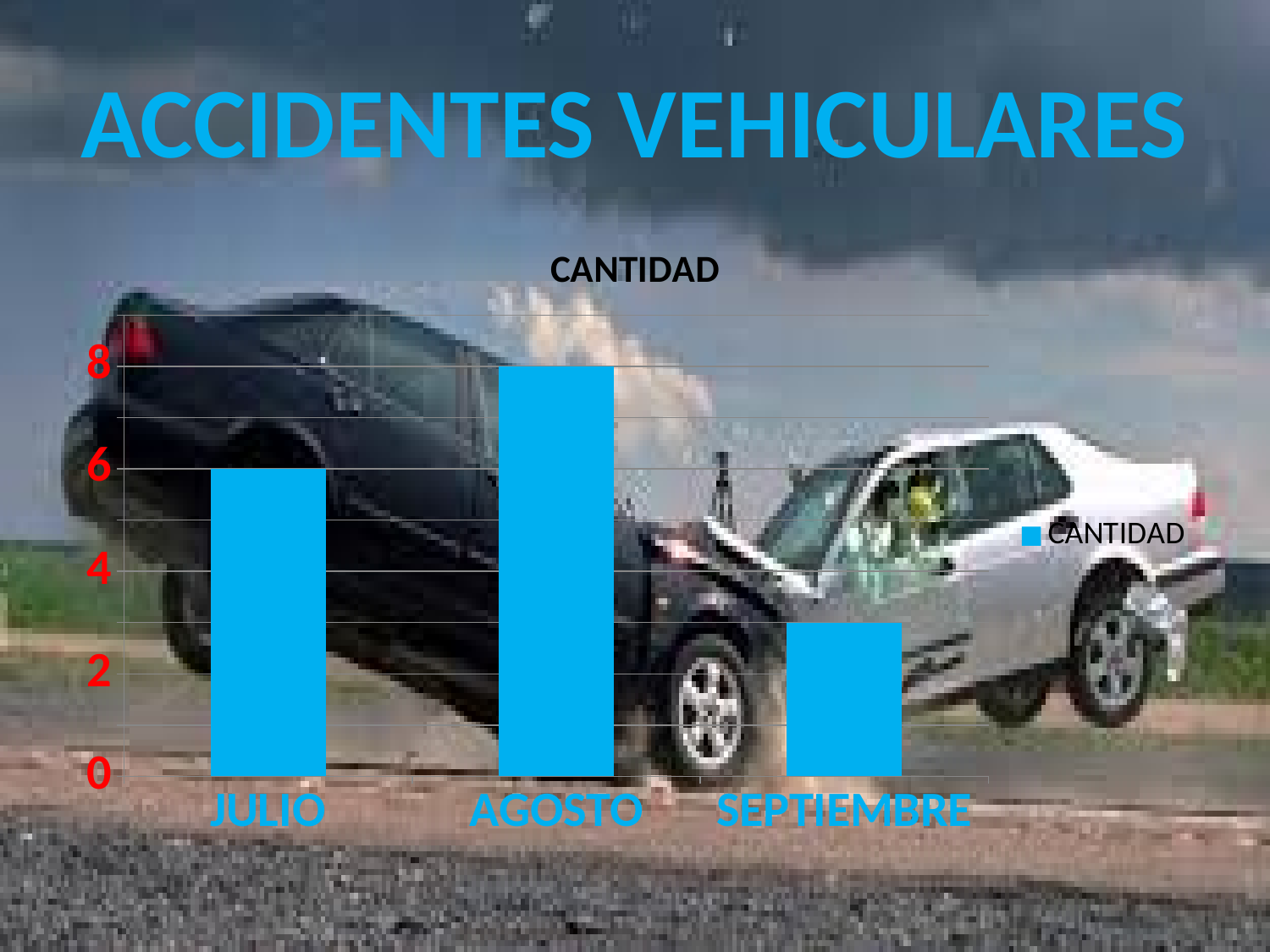
How many series does the legend list? 1 Is the value for SEPTIEMBRE greater or less than 4? less Which month has the highest value? AGOSTO Is the value for SEPTIEMBRE greater or less than 2? greater What is the title of the chart? CANTIDAD Which month has the lowest value? SEPTIEMBRE How many categories are shown on the x axis? 3 Which is larger, the value for JULIO or the value for SEPTIEMBRE? JULIO What is the value for AGOSTO? 8 What kind of chart is shown on the slide? bar chart What is the difference between the values for AGOSTO and JULIO? 2 What is the value for JULIO? 6